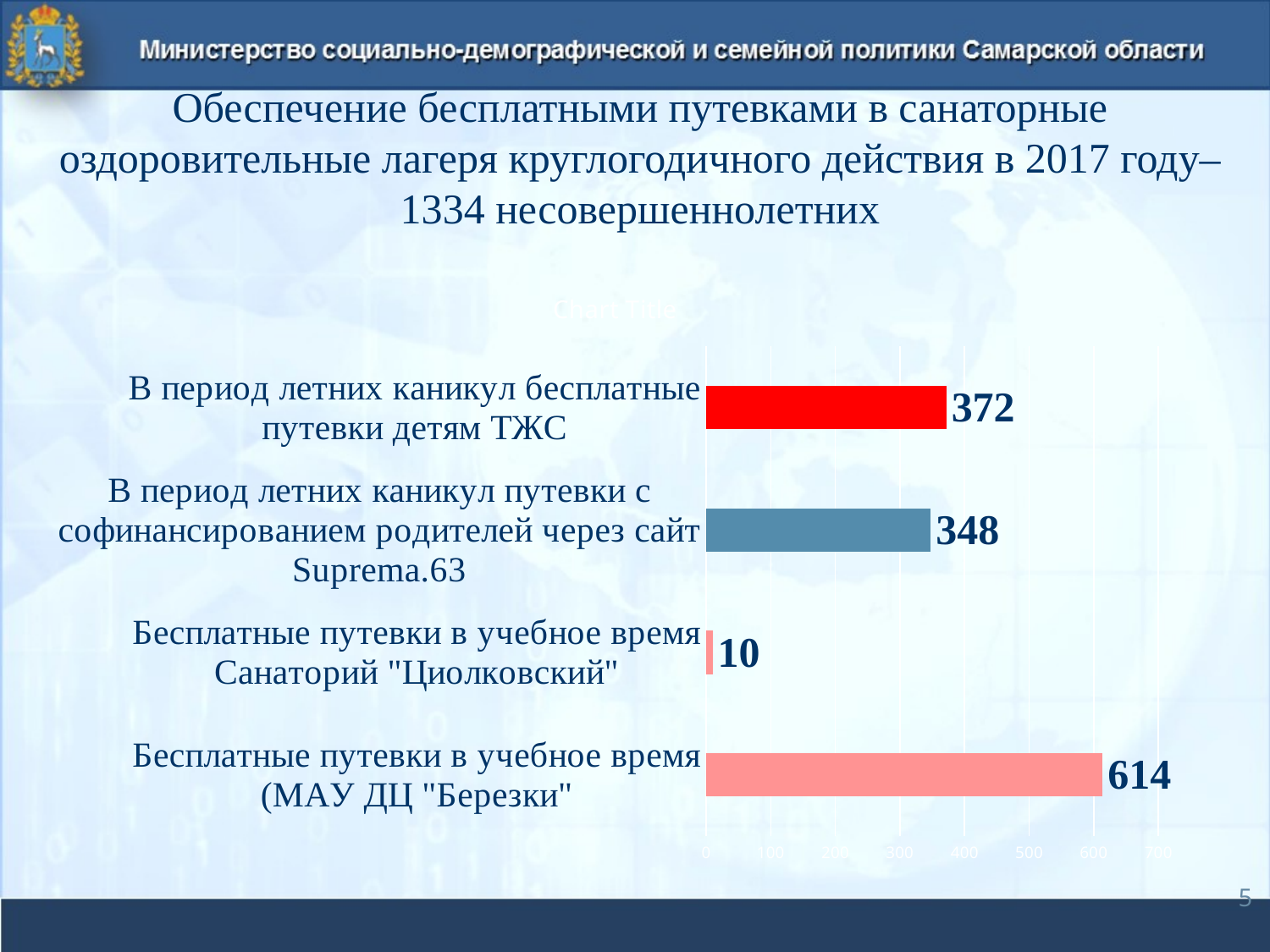
What value is shown for "Бесплатные путевки в учебное время (МАУ ДЦ "Березки""? 614 What kind of chart is shown on the slide? Bar chart What is the difference between the value for "Бесплатные путевки в учебное время (МАУ ДЦ "Березки"" and the value for "В период летних каникул бесплатные путевки детям ТЖС"? 242 Which category has the lowest value? Бесплатные путевки в учебное время Санаторий "Циолковский" Which is larger: the value for "В период летних каникул бесплатные путевки детям ТЖС" or the value for "Бесплатные путевки в учебное время Санаторий "Циолковский""? В период летних каникул бесплатные путевки детям ТЖС What is the difference between the value for "В период летних каникул бесплатные путевки детям ТЖС" and the value for "В период летних каникул путевки с софинансированием родителей через сайт Suprema.63"? 24 Which category has the highest value? Бесплатные путевки в учебное время (МАУ ДЦ "Березки" What value is shown for "В период летних каникул путевки с софинансированием родителей через сайт Suprema.63"? 348 What colour is the bar for "В период летних каникул бесплатные путевки детям ТЖС"? Red How many categories are shown in the chart? 4 What value is shown for "В период летних каникул бесплатные путевки детям ТЖС"? 372 What value is shown for "Бесплатные путевки в учебное время Санаторий "Циолковский""? 10